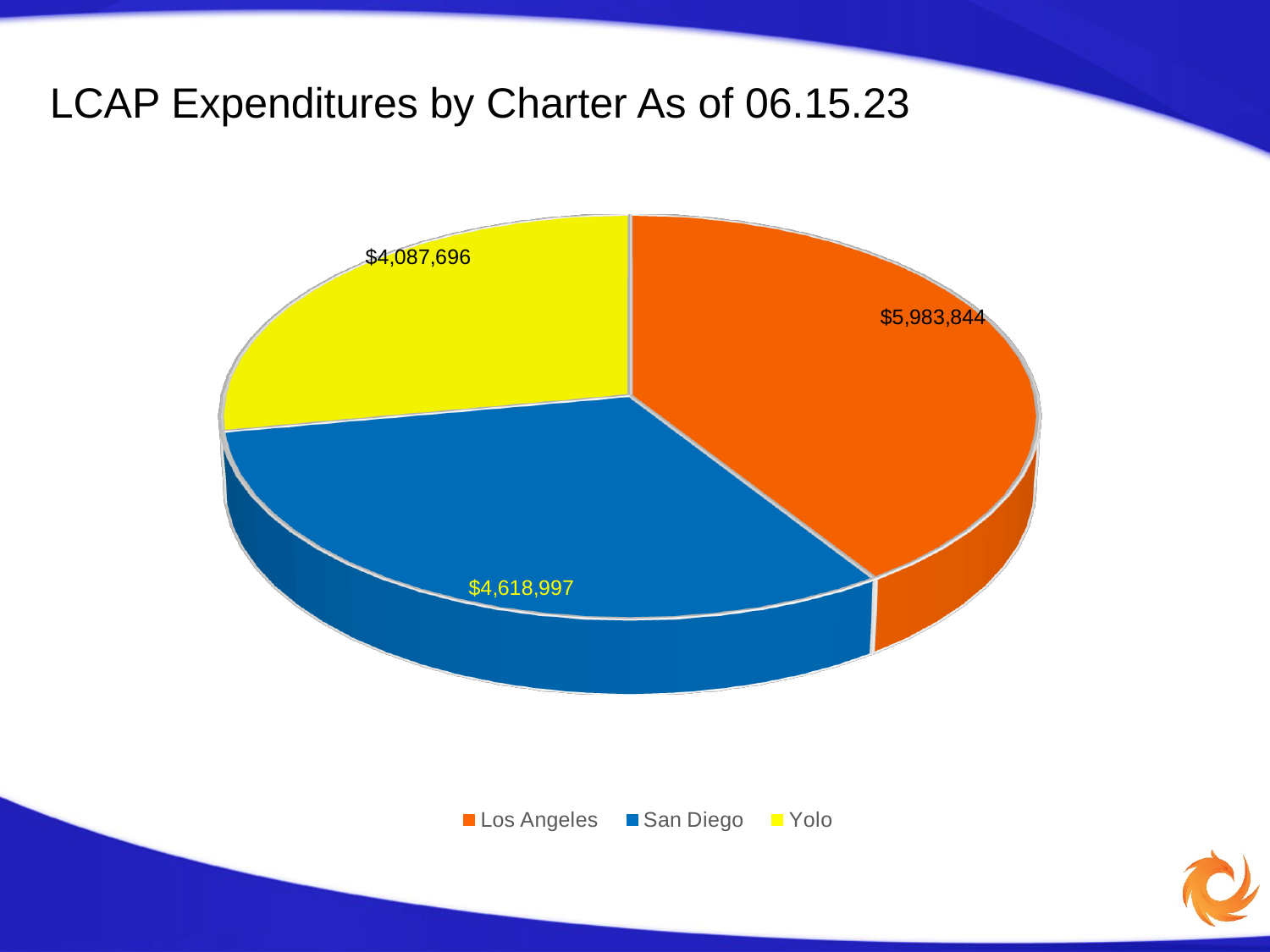
What is the LCAP expenditure value shown for San Diego? $4,618,997 Which is larger, the expenditure for San Diego or for Yolo? San Diego What is the total of all three charter expenditures shown? $14,690,537 What is the LCAP expenditure value shown for Los Angeles? $5,983,844 Which charter has the lowest LCAP expenditure? Yolo How many charters are shown in the pie chart? 3 What is the LCAP expenditure value shown for Yolo? $4,087,696 What is the difference between the Los Angeles and San Diego expenditures? $1,364,847 What is the difference between the San Diego and Yolo expenditures? $531,301 What is the title of the chart? LCAP Expenditures by Charter As of 06.15.23 Which charter has the highest LCAP expenditure? Los Angeles What kind of chart is shown on the slide? Pie chart